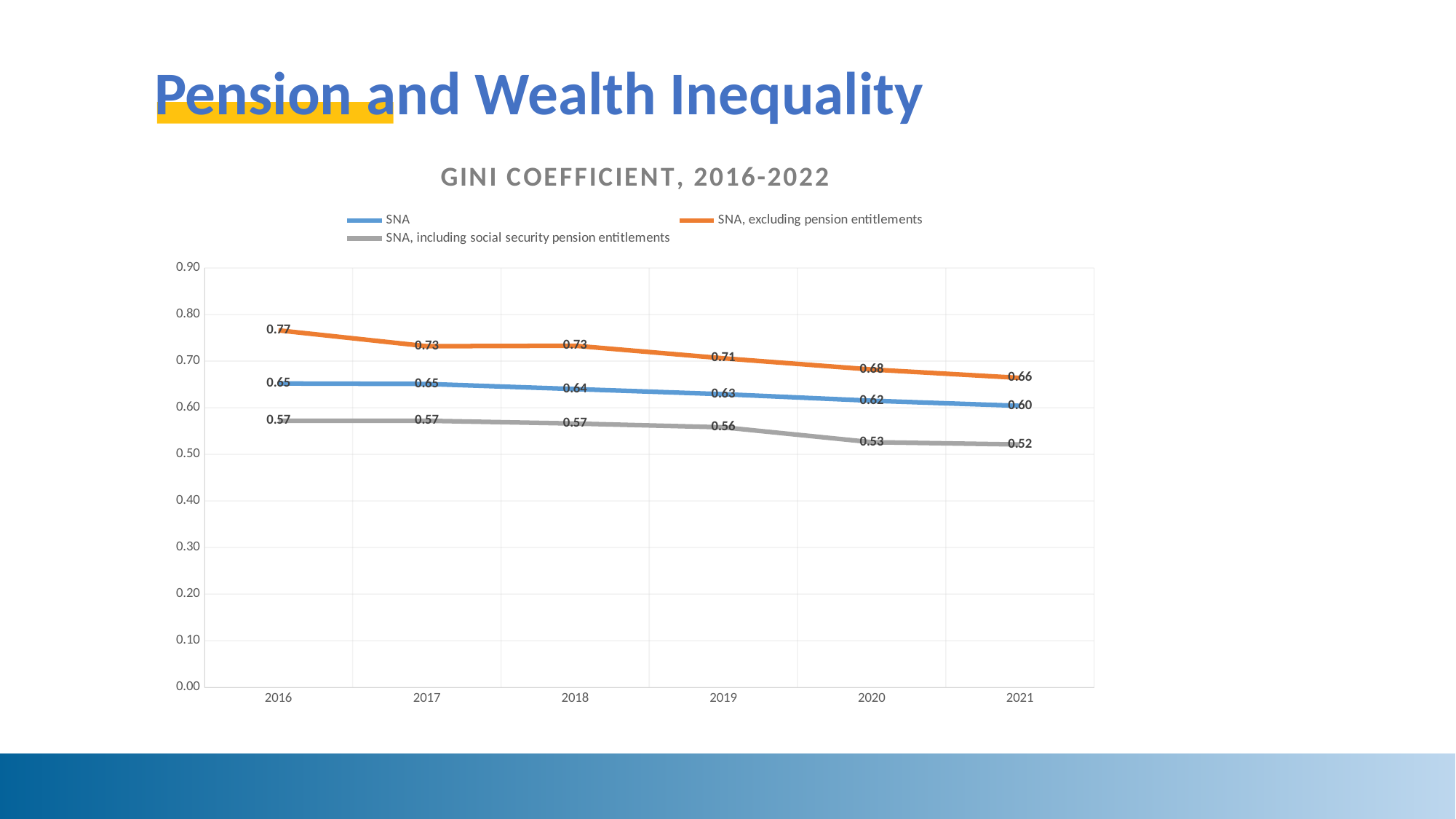
What kind of chart is shown on the slide? line chart How many series does the legend list? 3 Is the value for SNA, excluding pension entitlements in 2016 greater or less than 0.70? greater In which year is the SNA, including social security pension entitlements series lowest? 2021 What is the difference between the SNA, excluding pension entitlements value and the SNA value in 2021? 0.06 Which series has the larger value in 2020: SNA or SNA, including social security pension entitlements? SNA What is the value of the SNA, including social security pension entitlements series in 2021? 0.52 How many years are shown on the x axis? 6 What is the value of the SNA series in 2016? 0.65 Does the SNA series rise or fall from 2016 to 2021? fall What is the value of the SNA, excluding pension entitlements series in 2019? 0.71 In which year is the SNA, excluding pension entitlements series highest? 2016